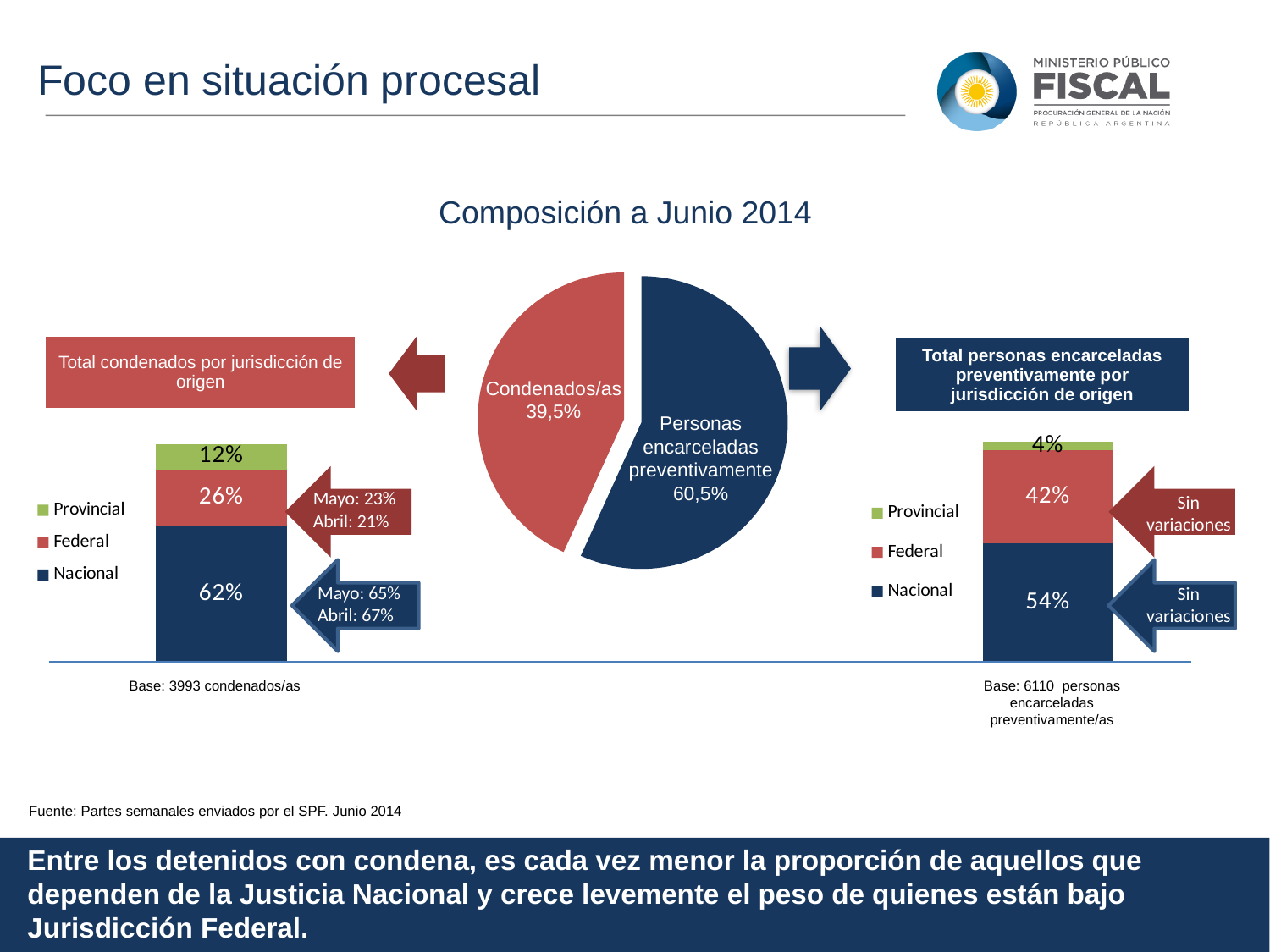
In the central pie chart, what share is labelled for Condenados/as? 39,5% What kind of chart is the left chart 'Total condenados por jurisdicción de origen'? Stacked bar chart How many series does the legend of the right chart 'Total personas encarceladas preventivamente por jurisdicción de origen' list? 3 In the left chart 'Total condenados por jurisdicción de origen', what is the value for Nacional? 62% How many slices does the central pie chart have? 2 In the left chart 'Total condenados por jurisdicción de origen', what is the difference between Nacional and Federal? 36% In the central pie chart, which slice is larger, Condenados/as or Personas encarceladas preventivamente? Personas encarceladas preventivamente In the right chart 'Total personas encarceladas preventivamente por jurisdicción de origen', what is the value for Federal? 42% In the central pie chart, what share is labelled for Personas encarceladas preventivamente? 60,5% In the right chart 'Total personas encarceladas preventivamente por jurisdicción de origen', which category has the highest value? Nacional In the left chart 'Total condenados por jurisdicción de origen', what is the value for Provincial? 12% In the left chart 'Total condenados por jurisdicción de origen', which category has the lowest value? Provincial